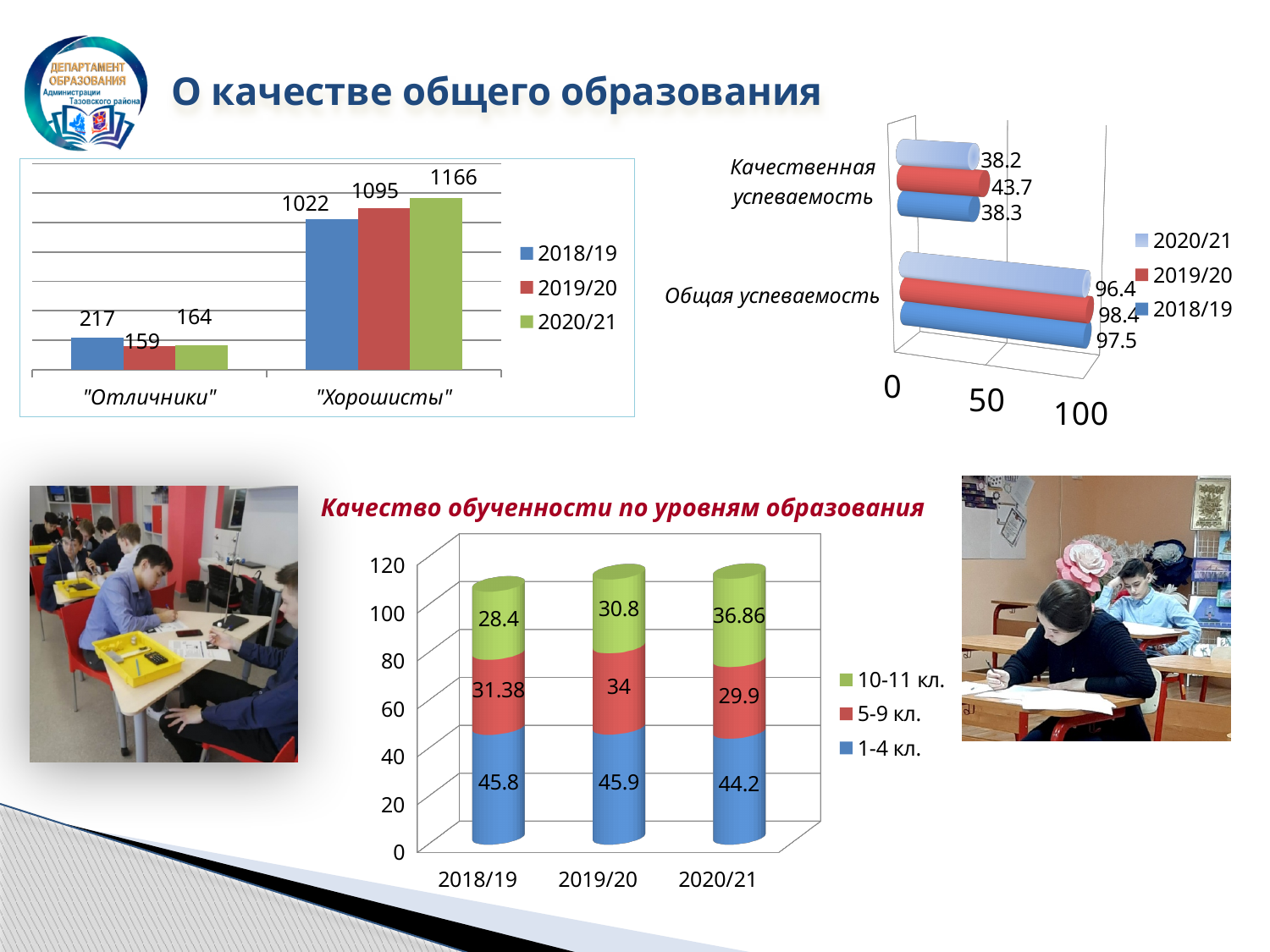
In the top-left chart, which year has the highest value for "Отличники"? 2018/19 In the top-right chart, what is the value of "Качественная успеваемость" for 2020/21? 38.2 In the chart "Качество обученности по уровням образования", what is the total of the stacked bar for 2019/20? 110.7 In the top-right chart, which year has the highest "Качественная успеваемость"? 2019/20 In the chart "Качество обученности по уровням образования", which is larger: the 5-9 кл. value in 2019/20 or in 2020/21? 2019/20 What kind of chart is "Качество обученности по уровням образования"? Stacked bar chart In the top-left chart, what is the value for "Отличники" in 2019/20? 159 In the top-left chart, what is the difference between the "Хорошисты" values for 2020/21 and 2018/19? 144 In the top-left chart, what is the value for "Хорошисты" in 2020/21? 1166 In the top-left chart, how many series does the legend list? 3 In the top-right chart, what is the value of "Общая успеваемость" for 2019/20? 98.4 In the chart "Качество обученности по уровням образования", what is the value for 10-11 кл. in 2020/21? 36.86